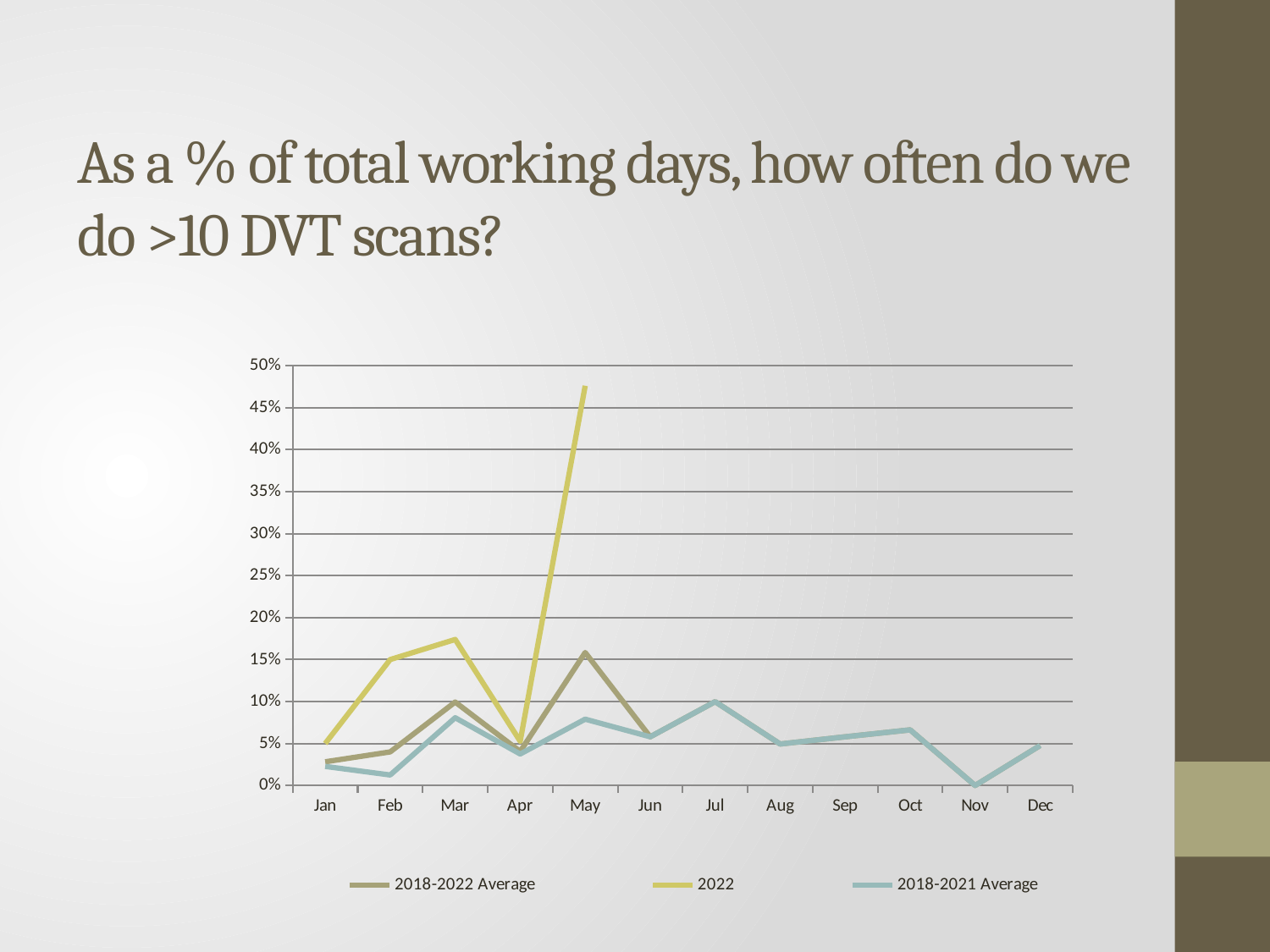
In Mar, which is larger: the 2022 value or the 2018-2021 Average value? 2022 Does the 2022 series rise or fall from Apr to May? Rises How many months are shown on the x axis? 12 What is the 2018-2021 Average value for Nov? 0% In which month is the 2018-2021 Average at its lowest? Nov Is the 2022 value for May greater or less than 45%? greater How many series does the legend list? 3 Is the 2018-2022 Average value for May greater or less than 10%? greater What type of chart is shown on the slide? Line chart In which month does the 2022 series reach its highest value? May Is the 2018-2021 Average value for Jul greater or less than 15%? less